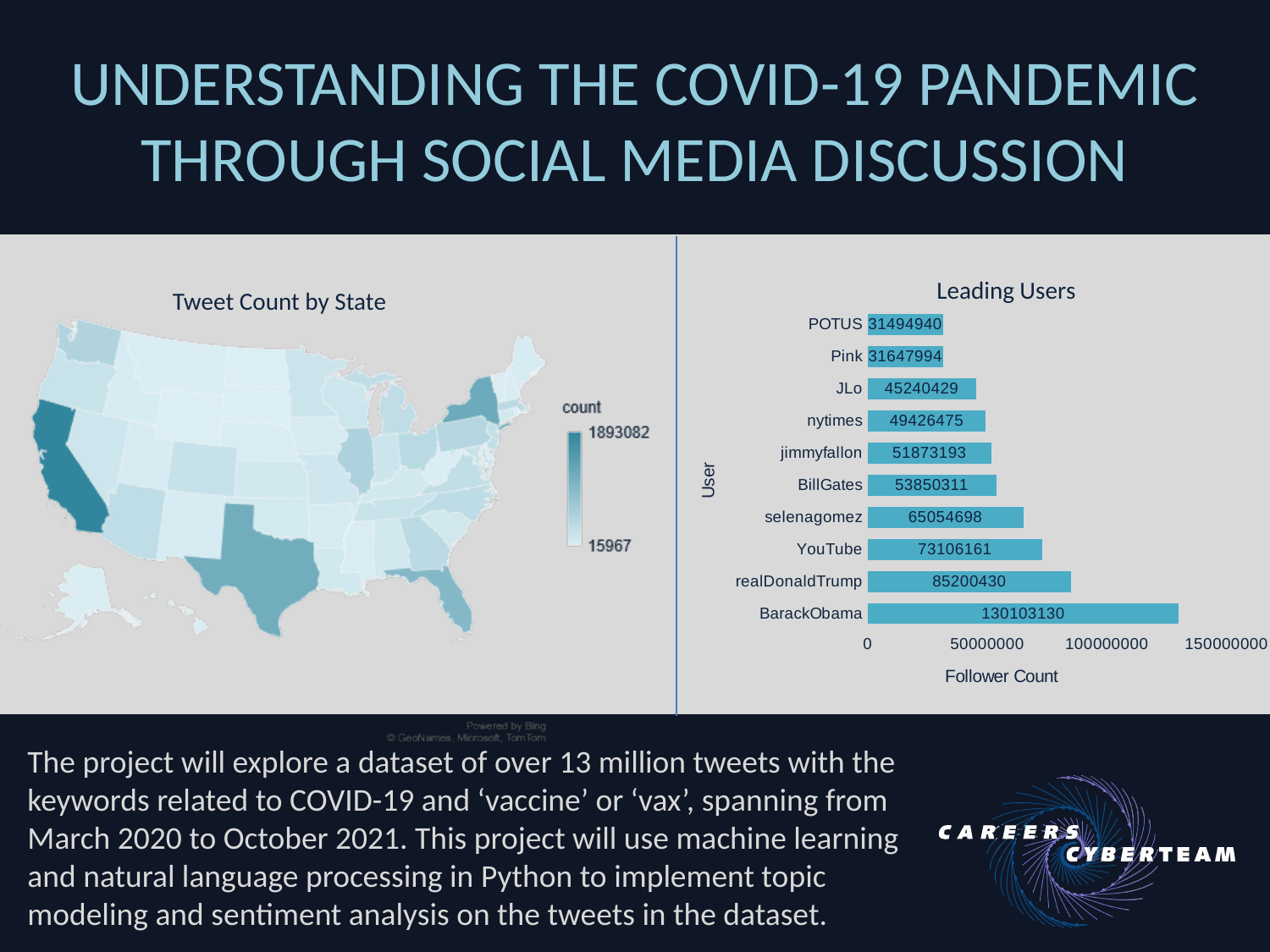
In the Leading Users chart, what is the follower count for BarackObama? 130103130 What is the x-axis title of the Leading Users chart? Follower Count In the Leading Users chart, who has more followers, jimmyfallon or JLo? jimmyfallon In the Leading Users chart, which user has the highest follower count? BarackObama In the Leading Users chart, what is the difference in follower count between BarackObama and realDonaldTrump? 44902700 In the Leading Users chart, what is the difference in follower count between YouTube and selenagomez? 8051463 In the Leading Users chart, what is the follower count for nytimes? 49426475 What kind of chart is the Leading Users chart? bar chart In the Leading Users chart, is the follower count for BarackObama greater or less than 100000000? greater How many users are shown in the Leading Users chart? 10 In the Tweet Count by State map, what is the highest value shown on the count legend? 1893082 In the Leading Users chart, what is the follower count for BillGates? 53850311